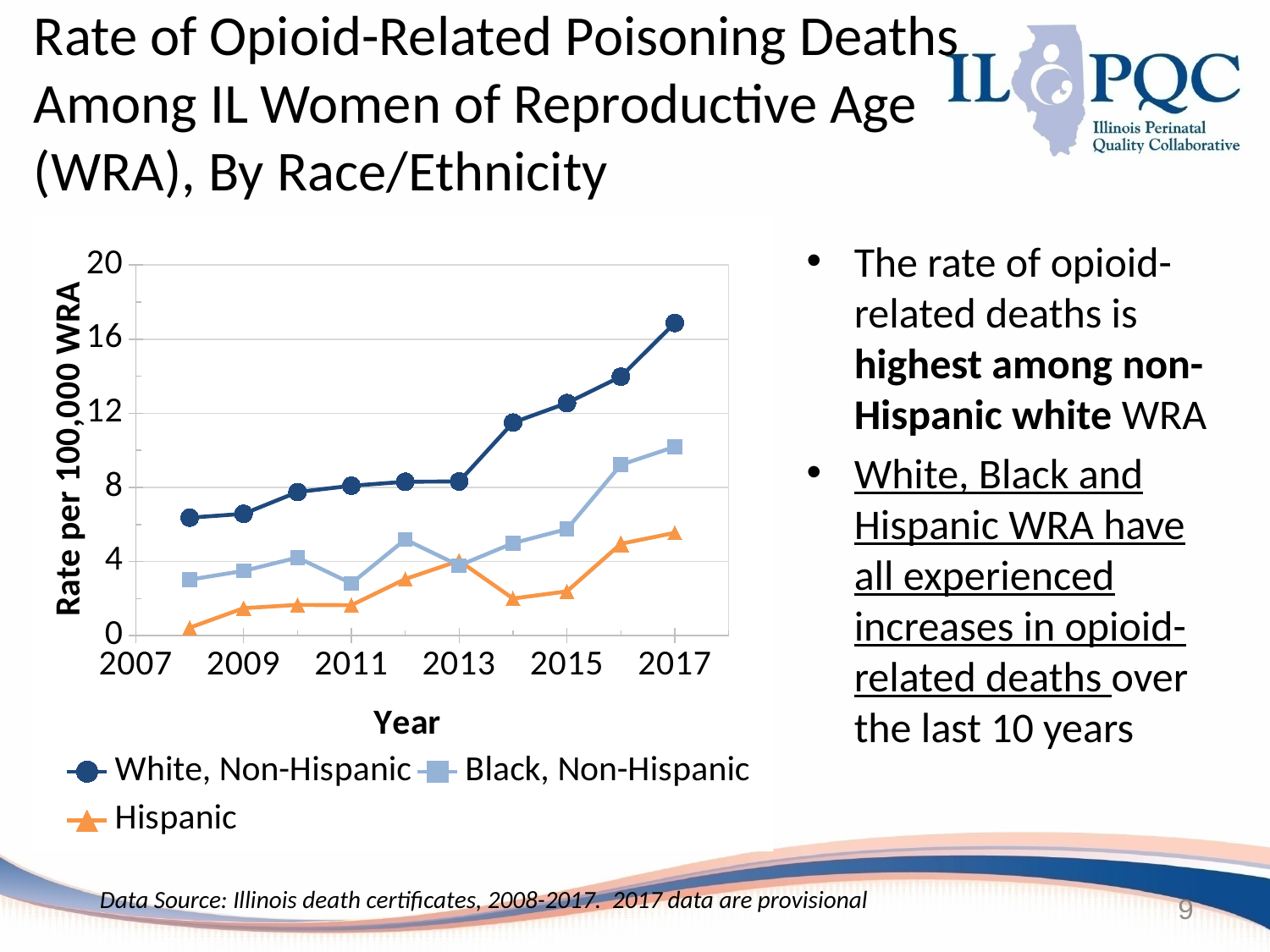
Which race/ethnicity group has the lowest rate in 2008? Hispanic Which race/ethnicity group has the highest rate in 2017? White, Non-Hispanic Is the value for White, Non-Hispanic in 2017 greater or less than 16? greater What is the label on the vertical axis of the chart? Rate per 100,000 WRA In 2016, which is larger: the rate for Black, Non-Hispanic or the rate for Hispanic? Black, Non-Hispanic Does the rate for White, Non-Hispanic WRA generally rise or fall from 2008 to 2017? Rise Is the value for White, Non-Hispanic in 2008 greater or less than 8? less Is the value for Hispanic in 2008 greater or less than 4? less How many data points are plotted for the White, Non-Hispanic series? 10 What kind of chart is shown on the slide? Line chart How many series does the legend list? 3